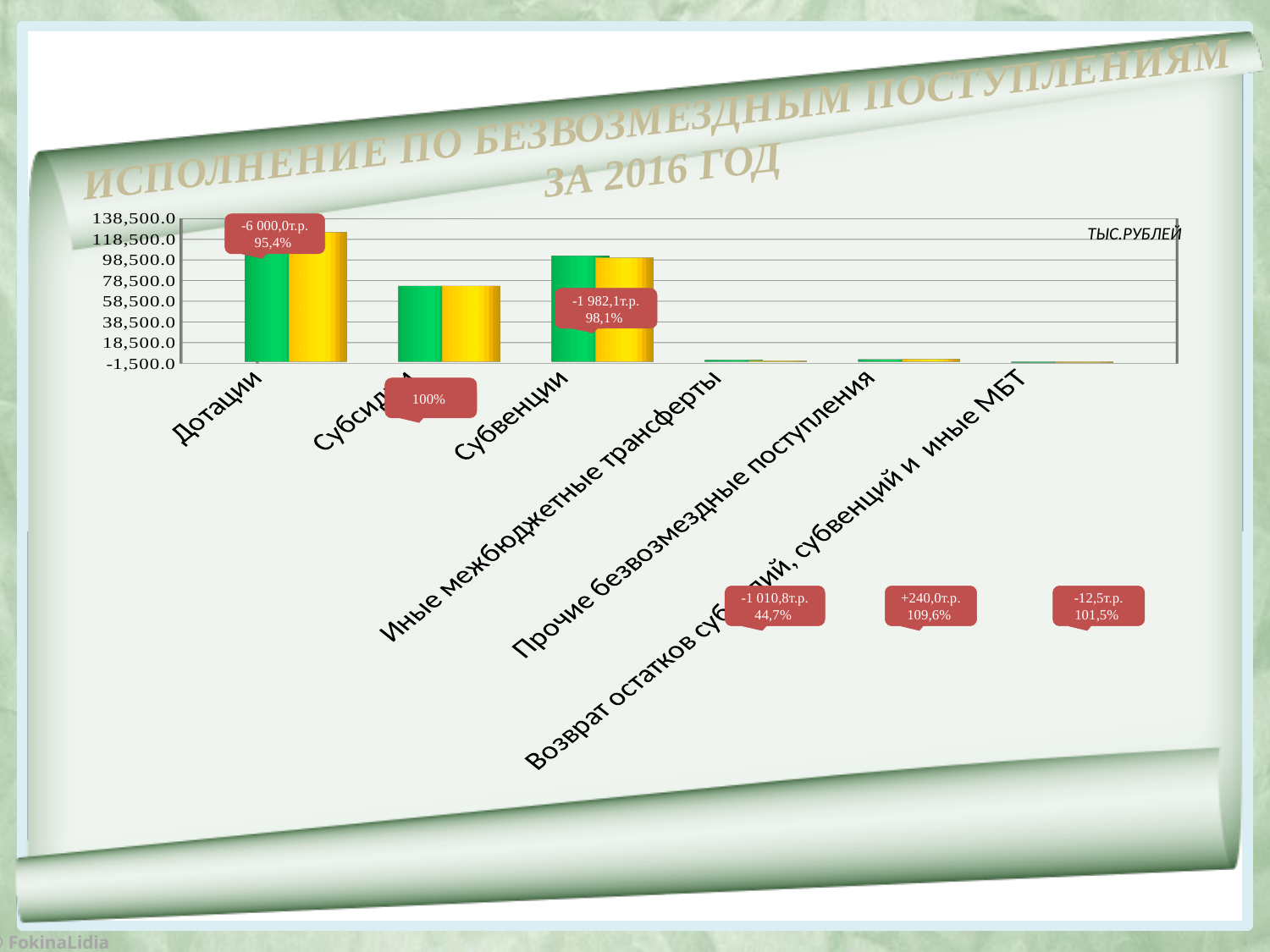
Is the value for Субсидии greater or less than 58,500.0? greater Is the value for Субвенции greater or less than 78,500.0? greater Which category has the highest bars on the chart? Дотации What deviation in thousand rubles is shown in the callout for Субвенции? -1 982,1т.р. What kind of chart is shown on the slide? bar chart What execution percentage is shown in the callout for Дотации? 95,4% What is the title of the chart on the slide? ИСПОЛНЕНИЕ ПО БЕЗВОЗМЕЗДНЫМ ПОСТУПЛЕНИЯМ ЗА 2016 ГОД Which category has taller bars, Дотации or Субсидии? Дотации How many categories are shown along the x axis of the chart? 6 In what units are the values on the chart expressed, according to the label on the slide? ТЫС.РУБЛЕЙ Which category has taller bars, Субвенции or Субсидии? Субвенции Is the value for Иные межбюджетные трансферты greater or less than 18,500.0? less